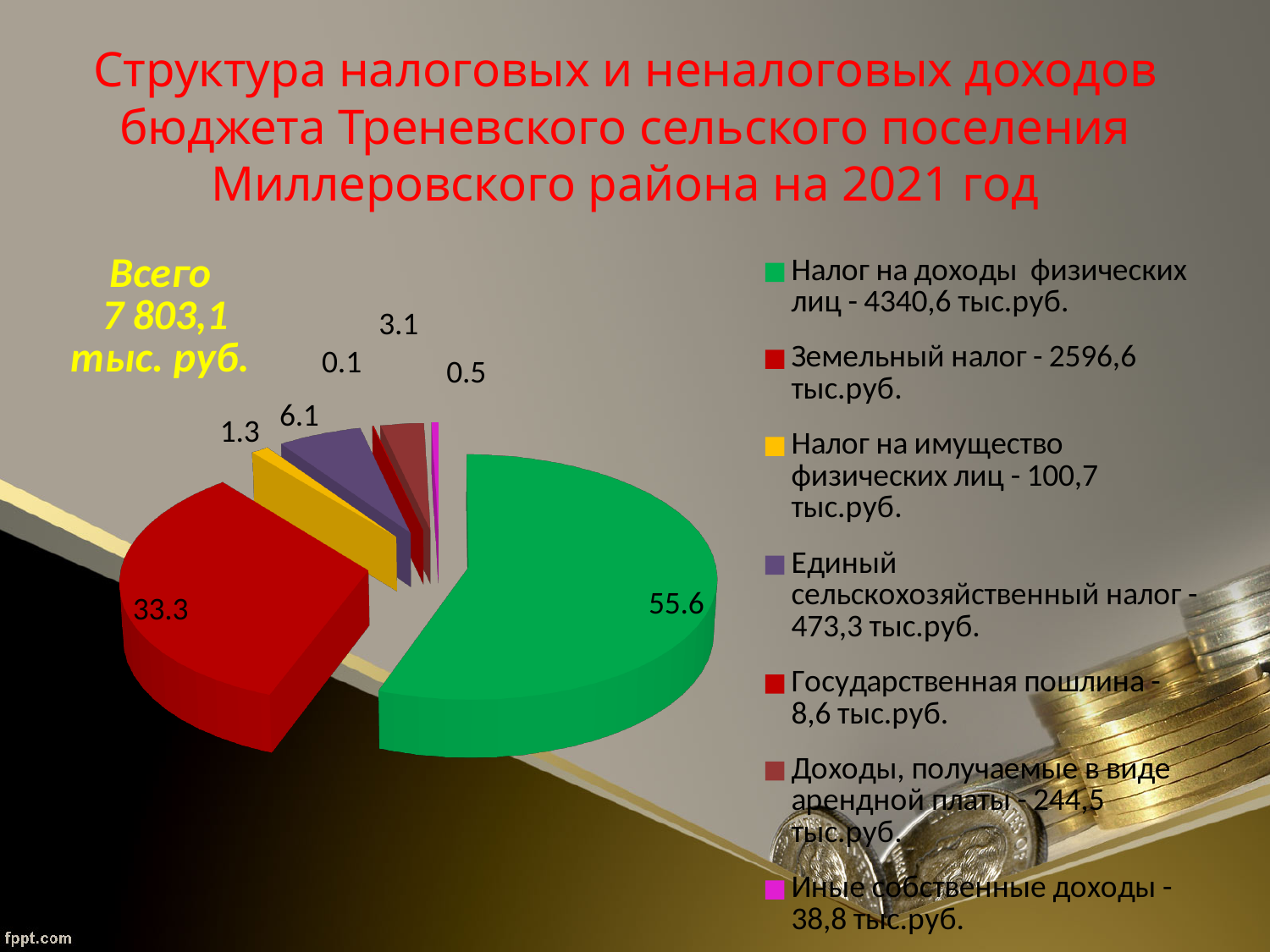
Which slice is larger: Единый сельскохозяйственный налог or Доходы, получаемые в виде арендной платы? Единый сельскохозяйственный налог Which category has the largest slice of the pie? Налог на доходы физических лиц How many entries does the legend list? 7 What is the difference between the labelled values for Налог на доходы физических лиц and Земельный налог? 22.3 What value is labelled on the slice for Иные собственные доходы? 0.5 Which category has the smallest slice of the pie? Государственная пошлина According to the legend, what amount is given for Земельный налог? 2596,6 тыс.руб. What total amount (Всего) is shown next to the chart? 7 803,1 тыс. руб. What kind of chart is shown on the slide? pie chart What value is labelled on the slice for Земельный налог? 33.3 How many slices does the pie chart have? 7 What value is labelled on the slice for Налог на доходы физических лиц? 55.6